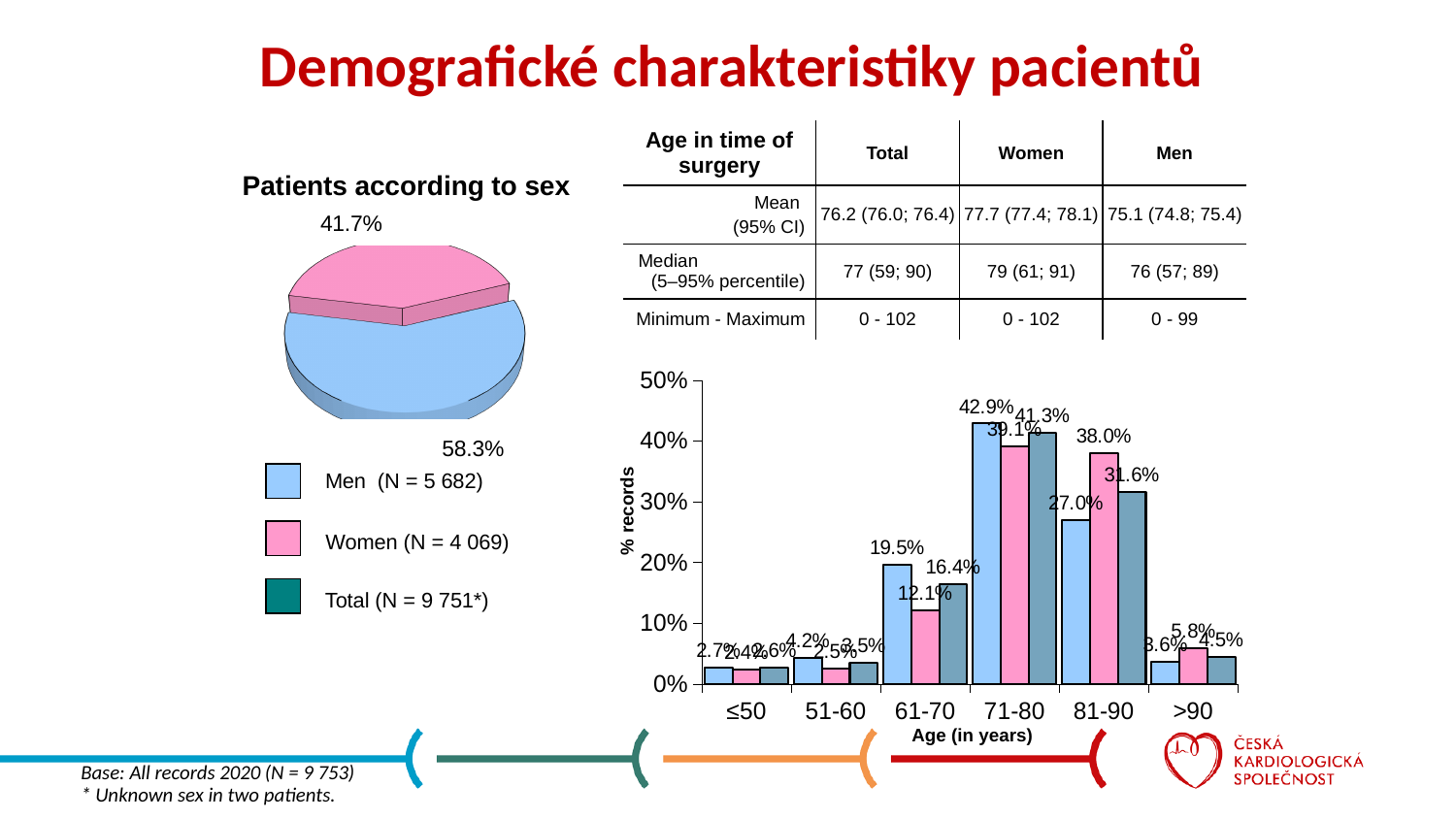
In the bar chart of age in years, what is the value for Men in the 71-80 age group? 42.9% What kind of chart is 'Patients according to sex'? Pie chart In the bar chart of age in years, which age group has the highest Total value? 71-80 In the pie chart 'Patients according to sex', what percentage of patients are men? 58.3% In the pie chart 'Patients according to sex', which group is larger, men or women? Men How many age groups are shown on the x axis of the bar chart? 6 In the bar chart of age in years, which is larger in the 61-70 age group, the Men value or the Women value? Men In the bar chart of age in years, what is the value for Total in the 61-70 age group? 16.4% What kind of chart shows the distribution of age in years? Bar chart In the bar chart of age in years, what is the value for Women in the 81-90 age group? 38.0% In the bar chart of age in years, what is the difference between the Women and Men values in the 81-90 age group? 11.0 percentage points In the bar chart of age in years, what is the value for Women in the 71-80 age group? 39.1%